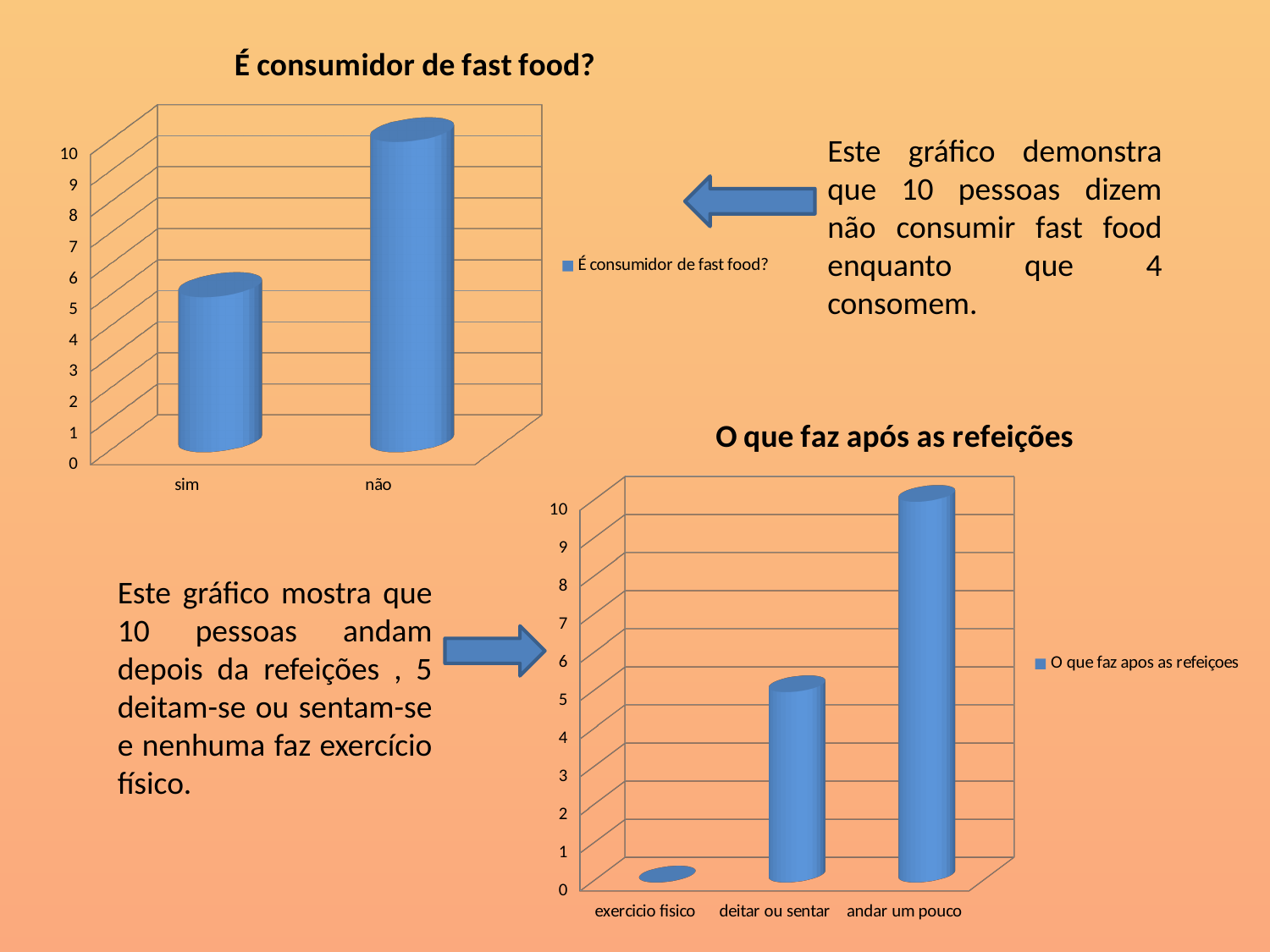
In the 'O que faz após as refeições' chart, which is larger, the value for 'deitar ou sentar' or the value for 'andar um pouco'? andar um pouco In the 'O que faz após as refeições' chart, which category has the highest value? andar um pouco How many categories are shown in the 'O que faz após as refeições' chart? 3 In the 'É consumidor de fast food?' chart, is the value for 'não' greater or less than 8? greater How many categories are shown in the 'É consumidor de fast food?' chart? 2 In the 'O que faz após as refeições' chart, is the value for 'deitar ou sentar' greater or less than 8? less What kind of chart is the 'É consumidor de fast food?' chart? bar chart In the 'O que faz após as refeições' chart, which category has the lowest value? exercicio fisico In the 'É consumidor de fast food?' chart, which category has the highest value? não In the 'É consumidor de fast food?' chart, which category has the lowest value? sim How many series does the legend of the 'É consumidor de fast food?' chart list? 1 In the 'É consumidor de fast food?' chart, is the value for 'sim' greater or less than 8? less